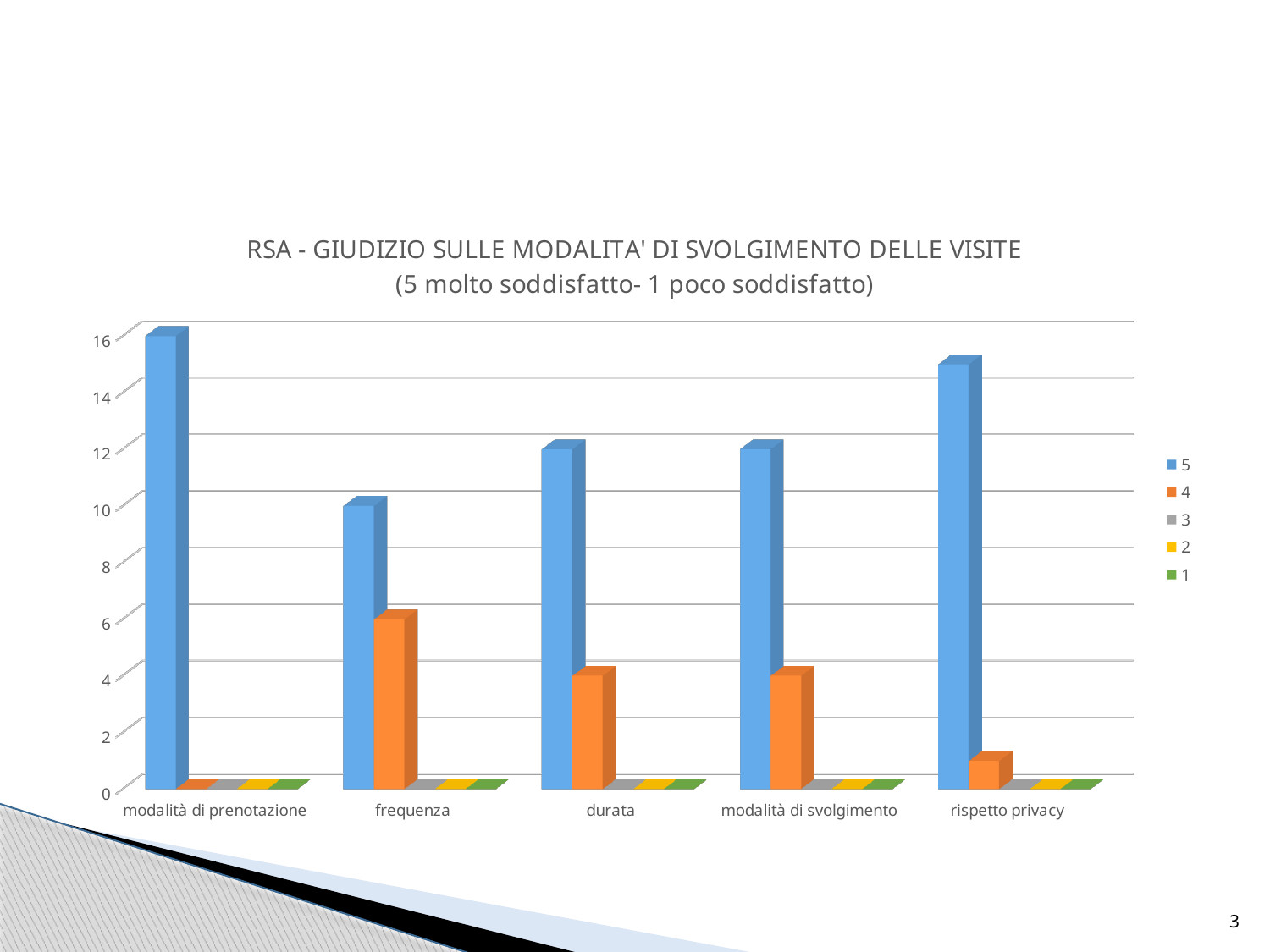
How many categories are shown on the x axis? 5 Which category has the lowest value for series 5? frequenza What kind of chart is shown on the slide? bar chart Is the value for series 4 in 'frequenza' greater or less than 8? less Which category has the highest value for series 5? modalità di prenotazione Is the value for series 5 in 'rispetto privacy' greater or less than 12? greater Which category has the highest value for series 4? frequenza Which is larger: series 4 for 'frequenza' or series 4 for 'rispetto privacy'? frequenza How many series does the legend list? 5 What is the title of the chart? RSA - GIUDIZIO SULLE MODALITA' DI SVOLGIMENTO DELLE VISITE (5 molto soddisfatto- 1 poco soddisfatto) Is the value for series 5 in 'modalità di prenotazione' greater or less than 14? greater Which is larger: series 5 for 'frequenza' or series 5 for 'durata'? durata